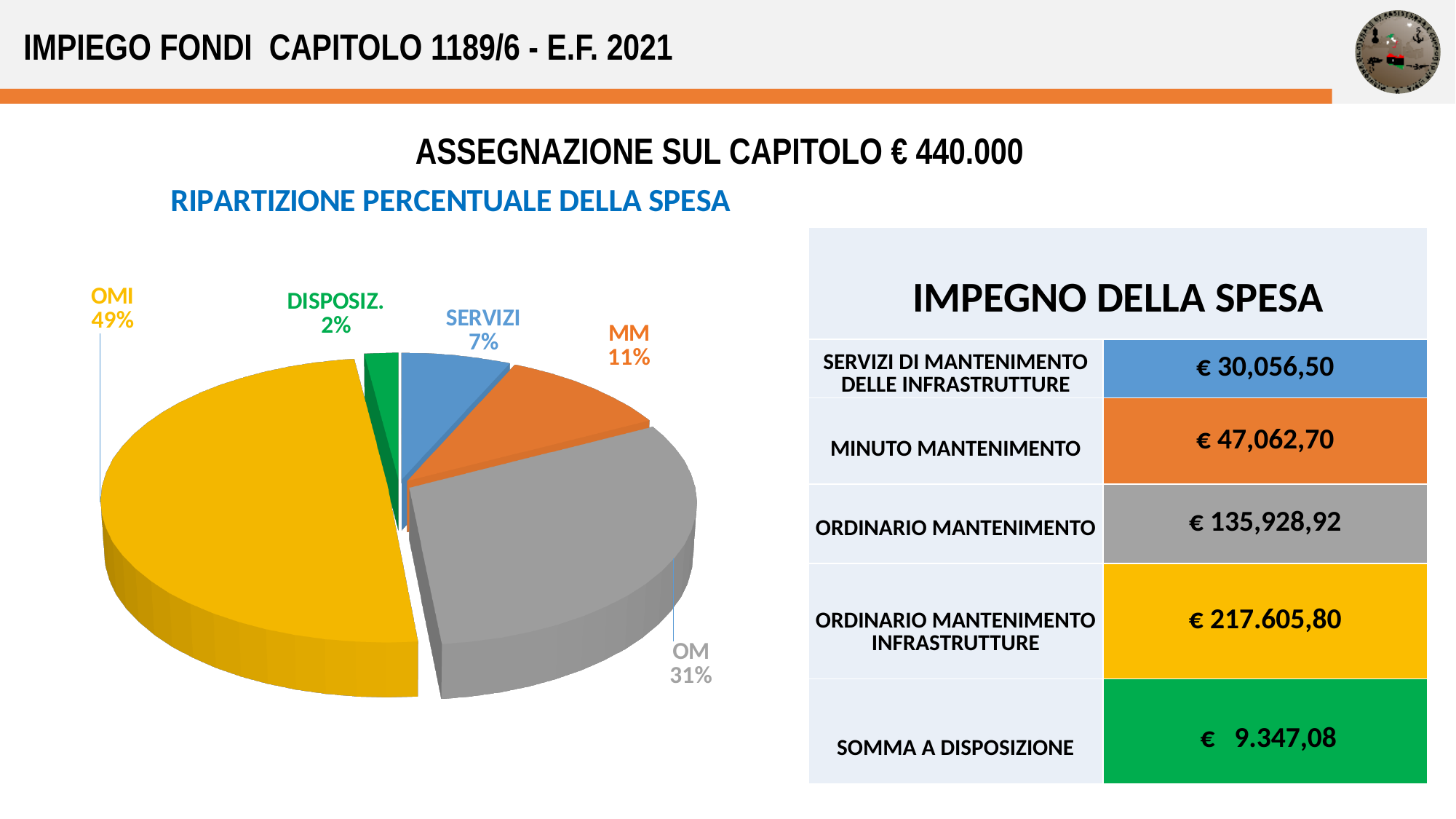
What share of the pie does SERVIZI represent? 7% Which slice is larger, MM or SERVIZI? MM What share of the pie does OMI represent? 49% What share of the pie does MM represent? 11% What is the difference in percentage points between the OMI slice and the OM slice? 18% Which slice of the pie is the smallest? DISPOSIZ. What is the title of the pie chart? RIPARTIZIONE PERCENTUALE DELLA SPESA Which slice of the pie is the largest? OMI What kind of chart is shown on the slide? Pie chart How many slices does the pie chart have? 5